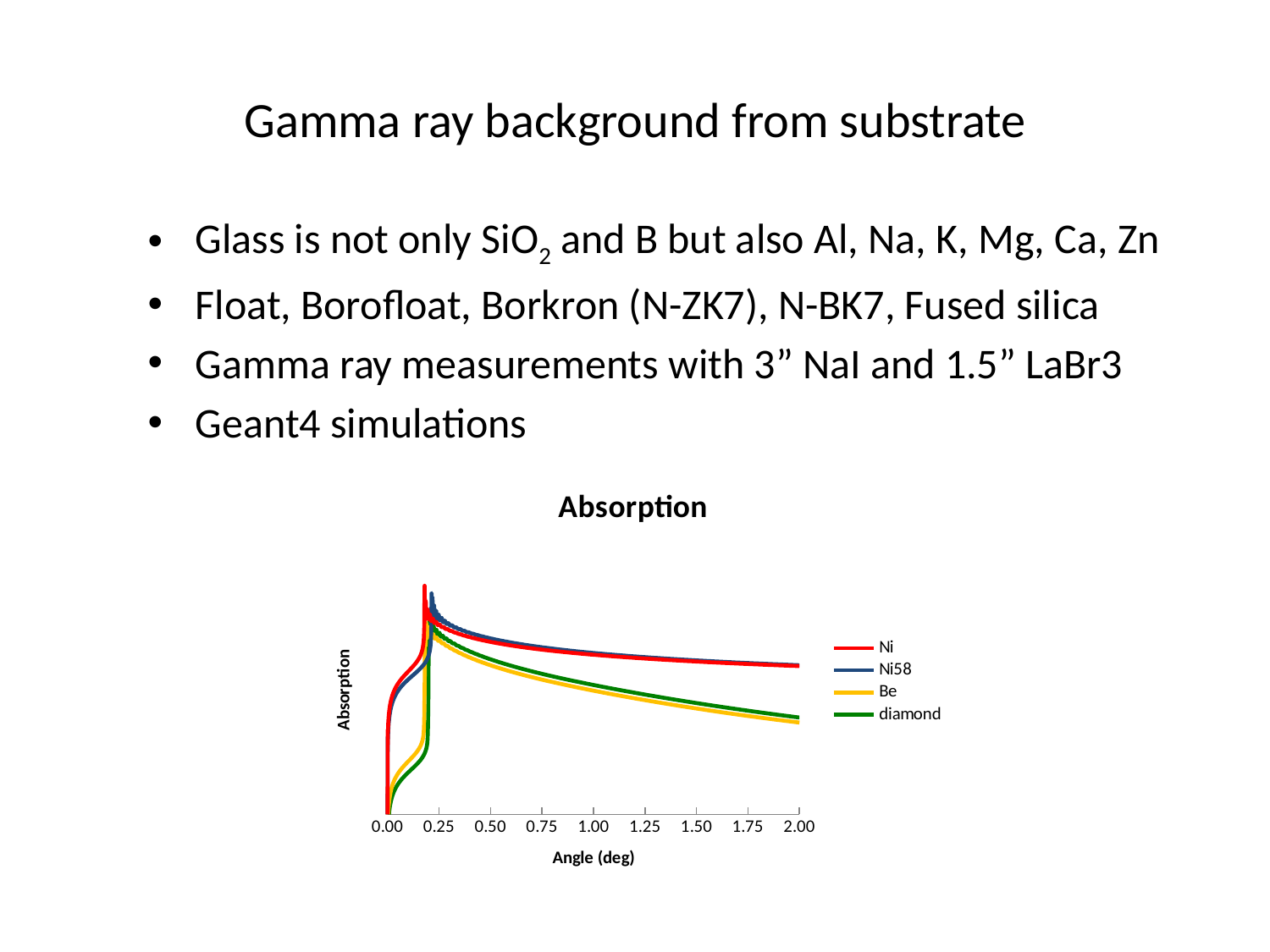
How many series does the legend of the Absorption chart list? 4 In the Absorption chart, which series has the higher absorption at an angle of 1.00 degrees, Ni58 or diamond? Ni58 In the Absorption chart, do the curves rise or fall as the angle increases from 0.50 to 2.00 degrees? fall What is the title of the chart on the slide? Absorption What kind of chart is shown on the slide? line chart In the Absorption chart, which series has the lowest absorption at an angle of 2.00 degrees? Be What is the label of the x axis of the Absorption chart? Angle (deg) In the Absorption chart, which series has the higher absorption at an angle of 2.00 degrees, Ni or Be? Ni In the Absorption chart, which series has the higher absorption at an angle of 0.10 degrees, Ni or Be? Ni